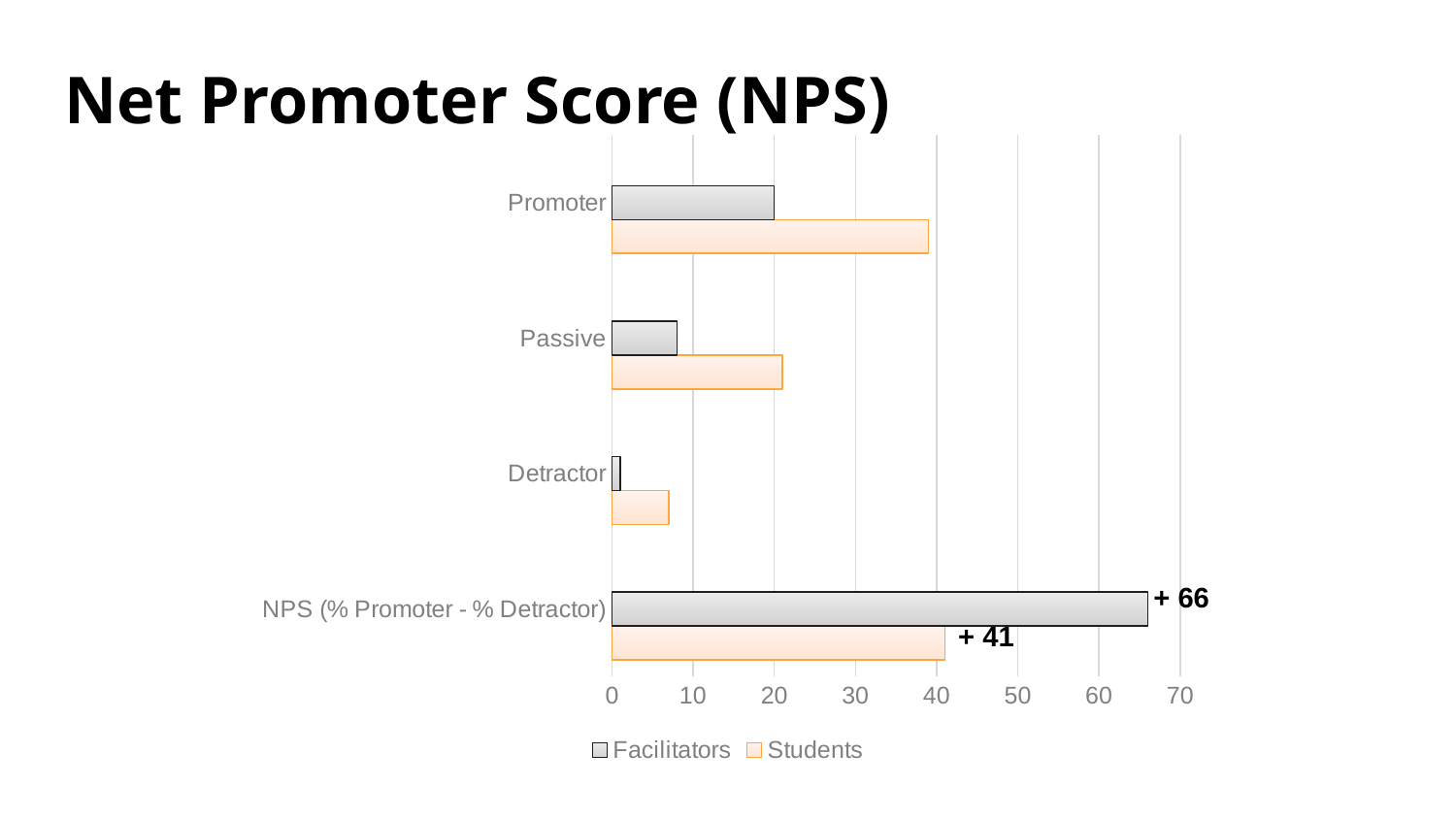
Is the Promoter value for Facilitators greater or less than 30? less What is the difference between the Facilitators NPS and the Students NPS? 25 How many categories are shown on the chart? 4 How many series does the legend list? 2 What is the NPS value for Students? + 41 Is the Passive value for Students greater or less than 10? greater What is the NPS value for Facilitators? + 66 Which group has the higher NPS, Facilitators or Students? Facilitators Which category has the lowest value for Facilitators? Detractor Is the Promoter value for Students greater or less than 30? greater Which category has the highest value for Students? NPS (% Promoter - % Detractor) What type of chart is shown on the slide? Bar chart